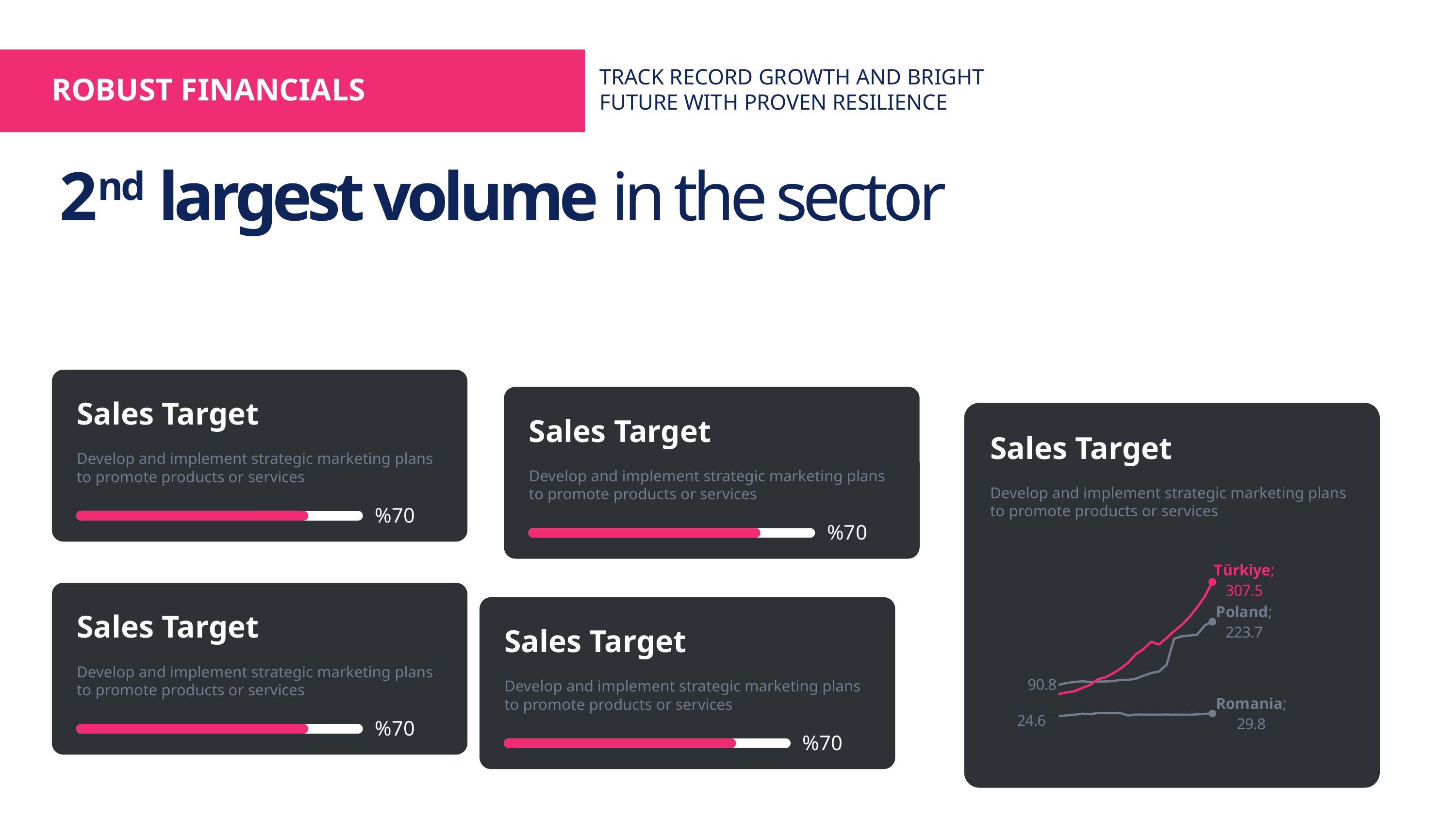
What kind of chart is shown in the right-hand Sales Target card? line chart In the line chart, does the Türkiye line rise or fall from left to right? rises In the line chart, what is the final value labelled for Poland? 223.7 In the line chart, what is the starting value labelled for the Romania line? 24.6 How many series (lines) are plotted in the line chart on the right? 3 In the line chart, which series ends with the highest value? Türkiye In the line chart, what is the difference between the final values of Poland and Romania? 193.9 In the line chart, what is the difference between the final values of Türkiye and Poland? 83.8 In the line chart, which has the larger final value, Poland or Romania? Poland In the line chart, what is the final value labelled for Türkiye? 307.5 In the line chart, what is the final value labelled for Romania? 29.8 In the line chart, which series ends with the lowest value? Romania